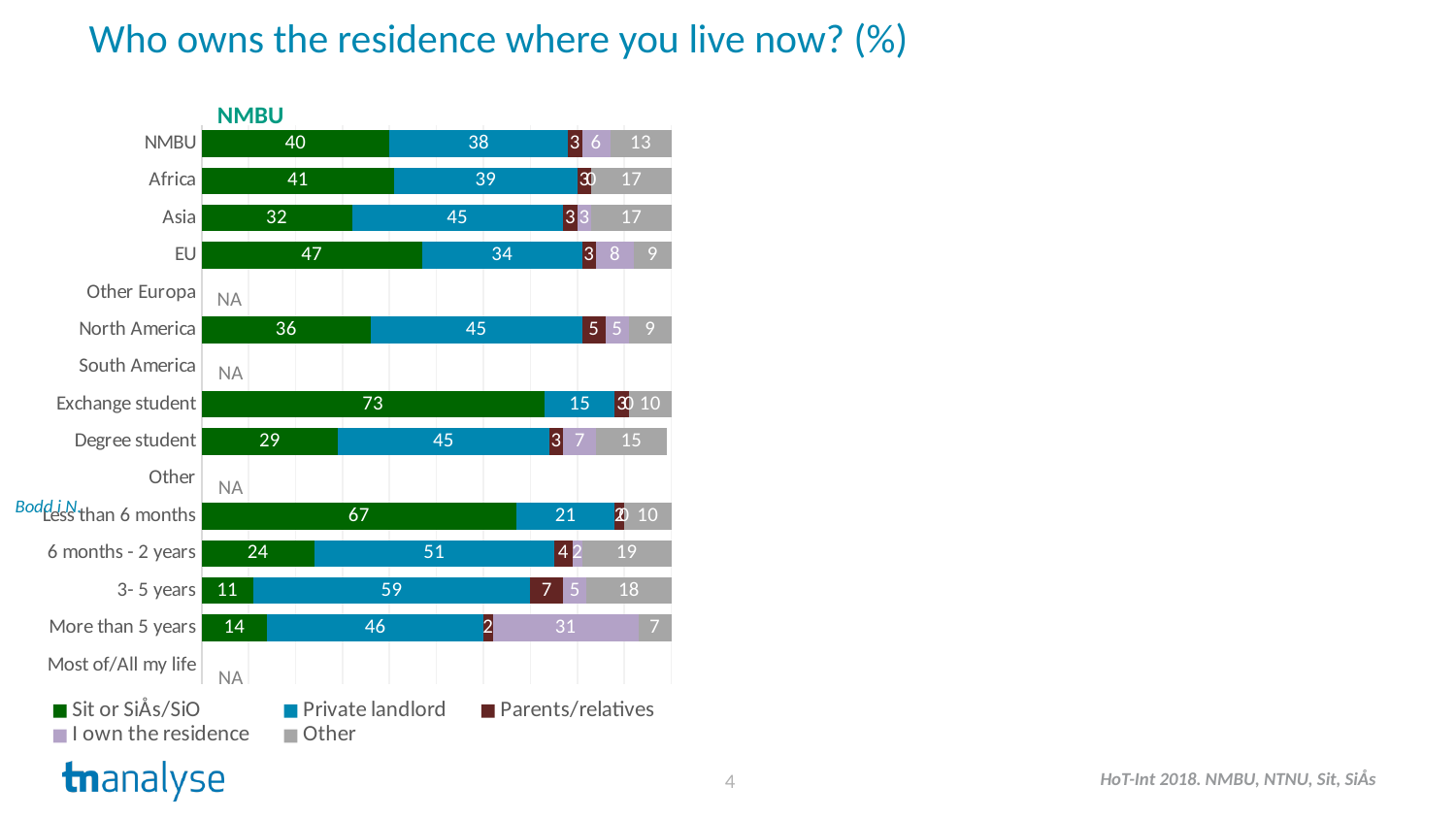
What type of chart is shown on the slide? Stacked bar chart What is the value for Other for 6 months - 2 years? 19 Which series is shown in dark green? Sit or SiÅs/SiO What is the value for Sit or SiÅs/SiO for Exchange student? 73 Which category has the lowest Sit or SiÅs/SiO value among those with data? 3- 5 years How many categories are marked NA? 4 What is the difference between the Private landlord values for 3- 5 years and Exchange student? 44 Which category has the highest Sit or SiÅs/SiO value? Exchange student What is the value for I own the residence for More than 5 years? 31 How many series does the legend list? 5 Which is larger: the Sit or SiÅs/SiO value for EU or for Asia? EU What is the value for Private landlord for 3- 5 years? 59